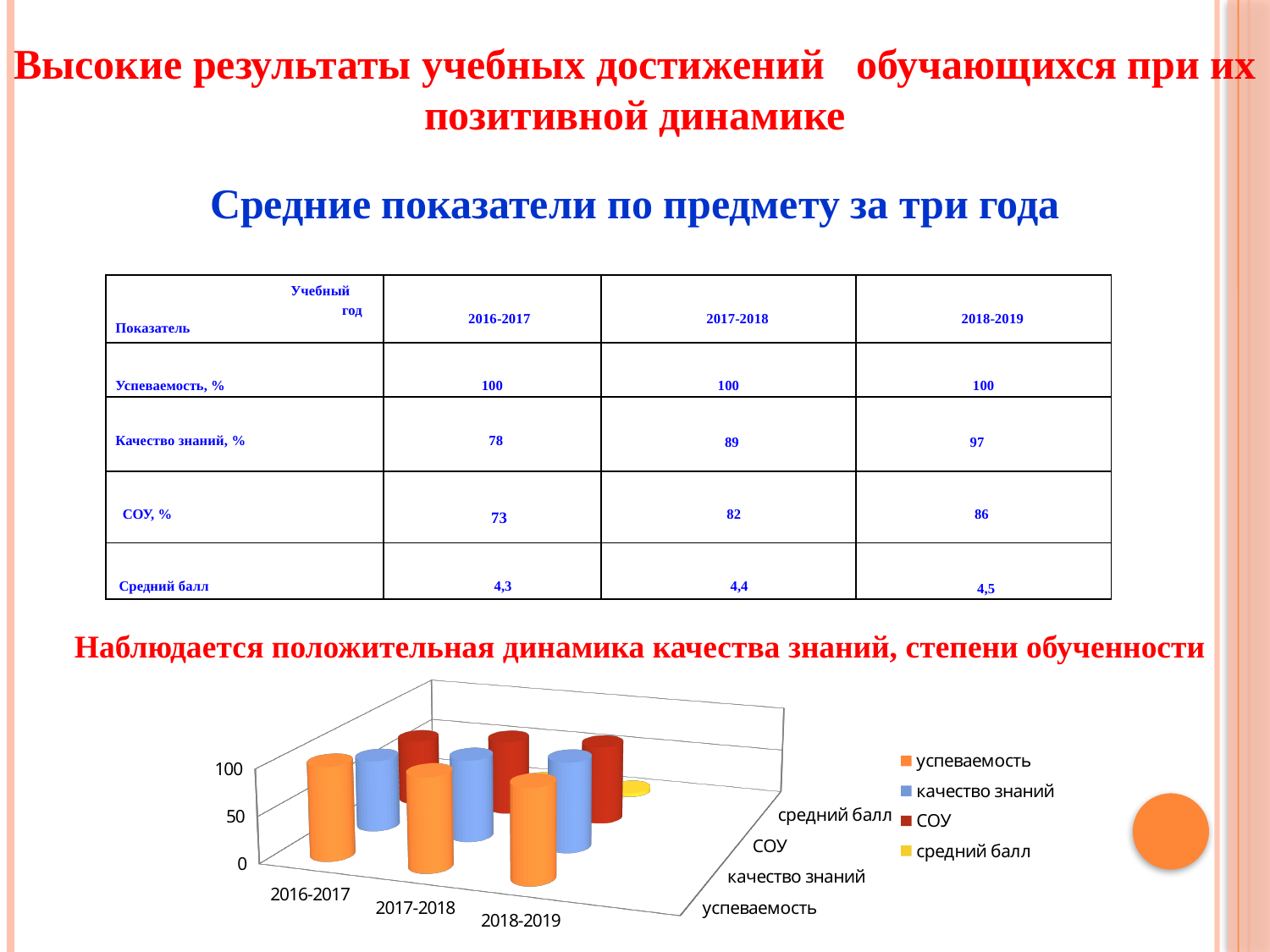
What is the highest tick value shown on the vertical axis of the chart? 100 Is the value for качество знаний in 2018-2019 greater or less than 50? greater Which series has the lowest bars in the chart across all years? средний балл Is the value for средний балл in 2018-2019 greater or less than 50? less Which series has the highest bars in the chart across all years? успеваемость What kind of chart is shown at the bottom of the slide? bar chart Is the value for успеваемость in 2016-2017 greater or less than 50? greater Which series is shown in yellow in the chart legend? средний балл How many series does the chart legend list? 4 How many academic years are shown along the x axis of the chart? 3 Which series is shown in orange in the chart legend? успеваемость